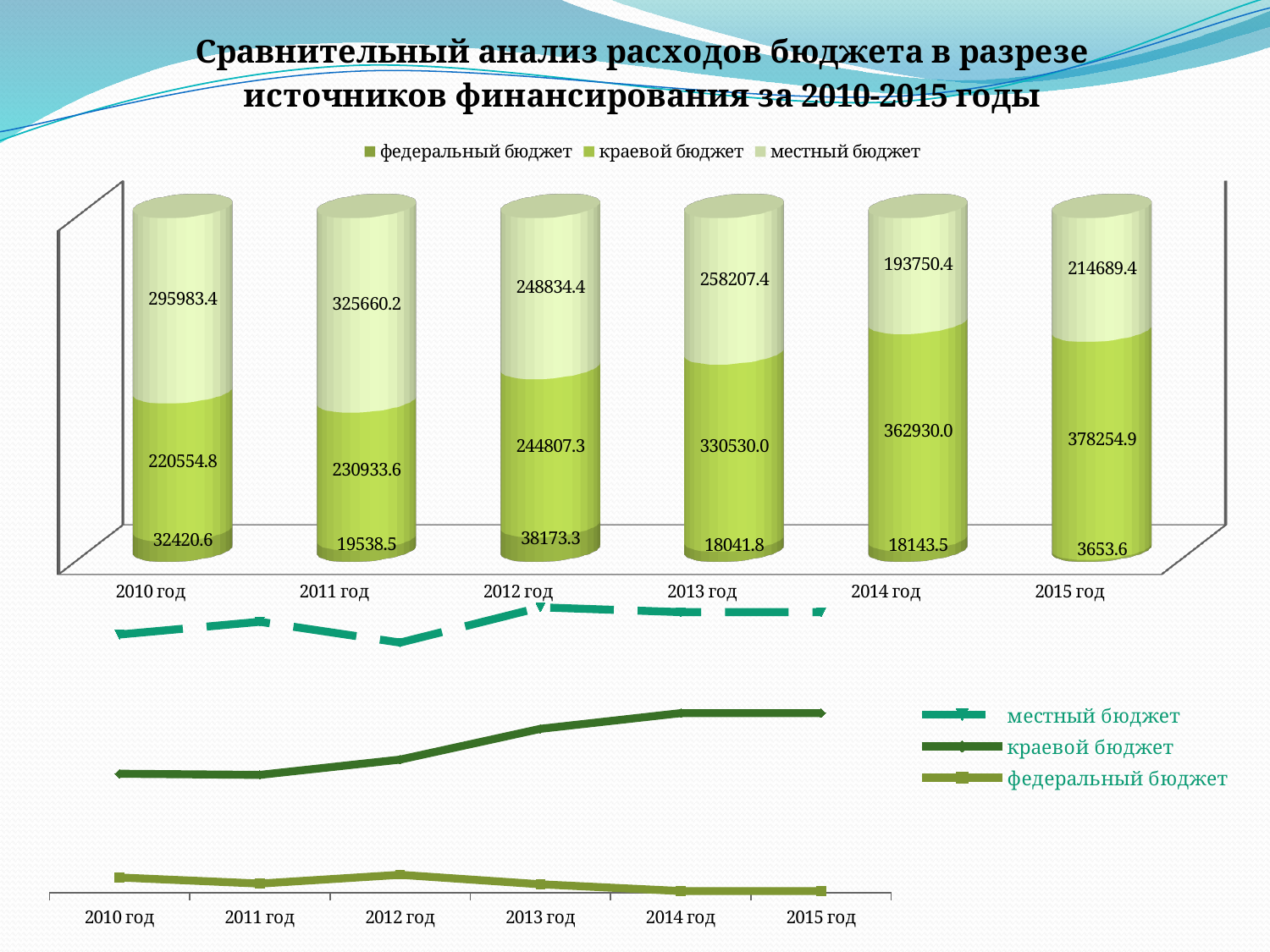
In the stacked bar chart at the top, what is the value for федеральный бюджет in 2012 год? 38173.3 In the stacked bar chart at the top, which year has the highest value for местный бюджет? 2011 год In the stacked bar chart at the top, what is the total of the three segments for 2010 год? 548958.8 In the stacked bar chart at the top, which year has the lowest value for федеральный бюджет? 2015 год In the line chart at the bottom, does the краевой бюджет line rise or fall from 2010 год to 2015 год? rise In the stacked bar chart at the top, which is larger: краевой бюджет in 2013 год or местный бюджет in 2013 год? краевой бюджет in 2013 год What kind of chart is the lower chart on the slide? line chart In the stacked bar chart at the top, how many years are shown on the x axis? 6 In the stacked bar chart at the top, what is the difference between the местный бюджет values for 2011 год and 2010 год? 29676.8 How many series does the legend of the top chart list? 3 In the stacked bar chart at the top, what is the value for краевой бюджет in 2015 год? 378254.9 In the stacked bar chart at the top, what is the value for местный бюджет in 2014 год? 193750.4